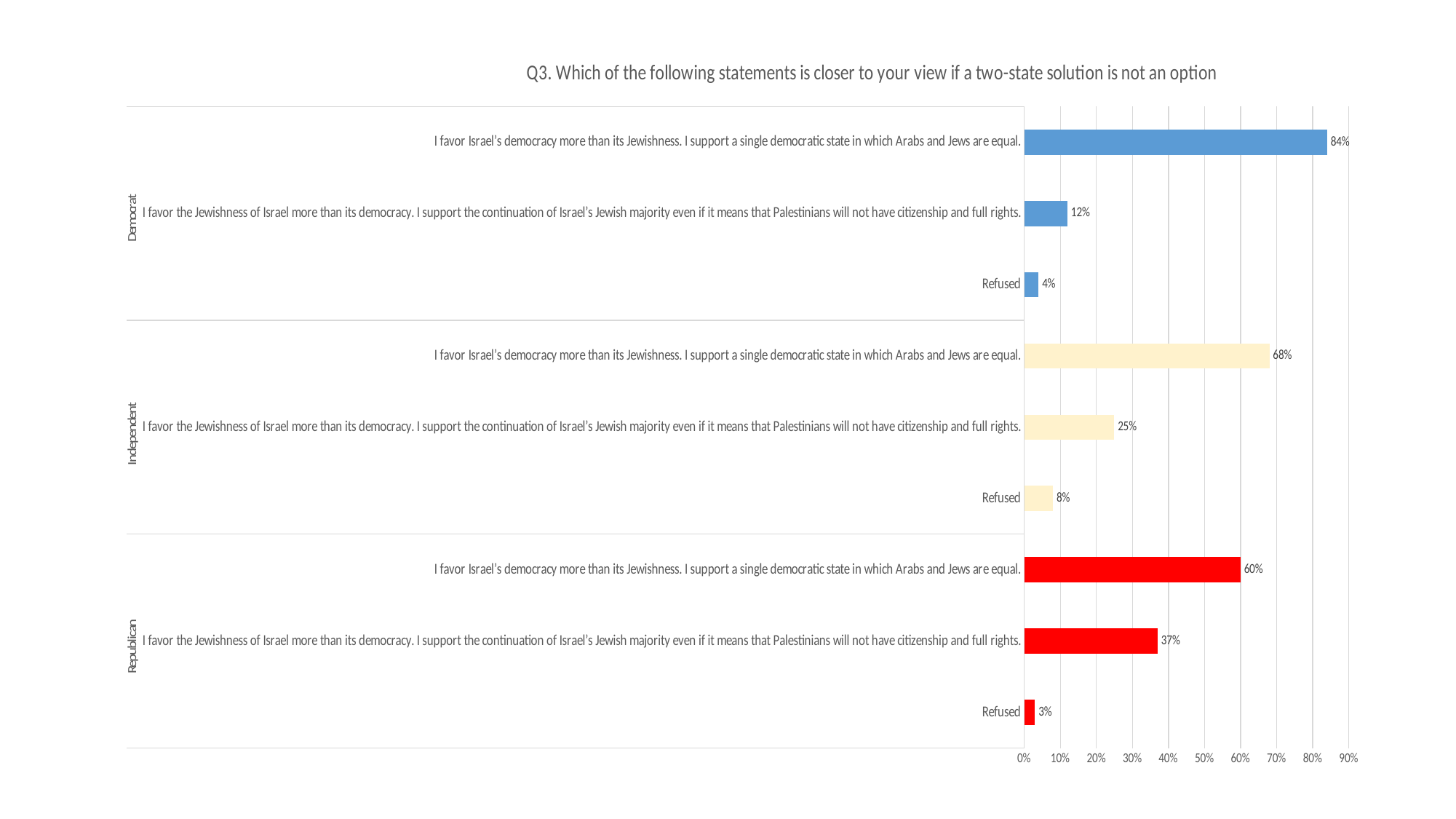
Which is larger: the Independent share favoring the Jewishness of Israel or the Republican share favoring the Jewishness of Israel? Republican Is the Republican value for favoring Israel's democracy more than its Jewishness greater or less than 50%? greater Which party group has the highest share favoring Israel's democracy more than its Jewishness? Democrat What percentage of Democrats favor Israel's democracy more than its Jewishness? 84% What percentage of Independents favor Israel's democracy more than its Jewishness? 68% What kind of chart is shown on the slide? Bar chart What is the difference between the Democrat and Republican shares favoring Israel's democracy more than its Jewishness? 24% How many bars are plotted on the chart? 9 Which party group has the lowest share of refused responses? Republican What colour are the bars for the Republican group? Red What percentage of Independents refused to answer? 8% What percentage of Republicans favor the Jewishness of Israel more than its democracy? 37%